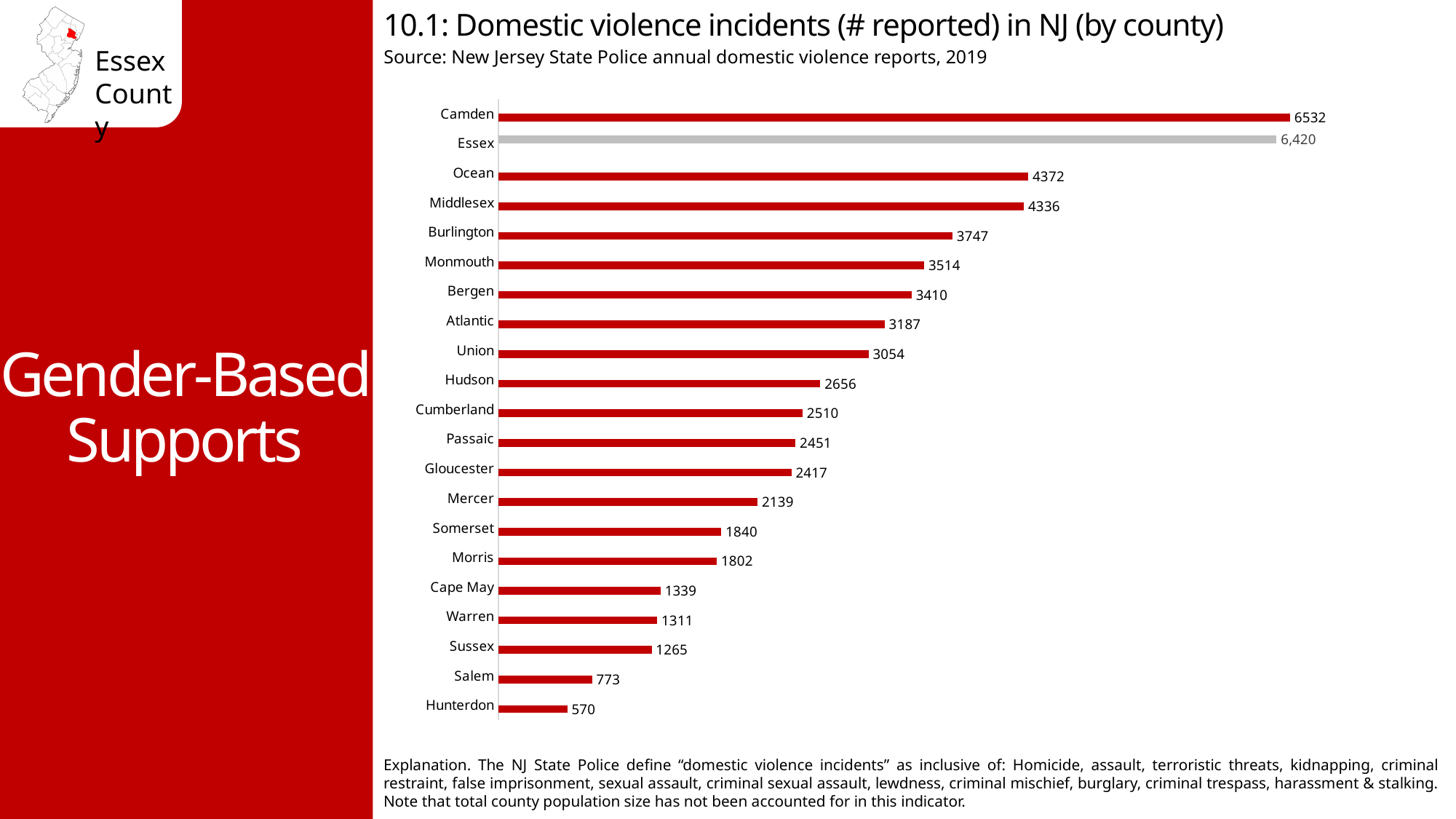
What is the number of domestic violence incidents reported for Cape May County? 1339 Which county has more reported incidents, Hudson or Mercer? Hudson What is the difference between the number of incidents in Salem and Hunterdon? 203 What is the number of domestic violence incidents reported for Bergen County? 3410 Which county has the highest number of reported domestic violence incidents? Camden What is the number of domestic violence incidents reported for Essex County? 6,420 Which county has the lowest number of reported domestic violence incidents? Hunterdon What type of chart is used to show domestic violence incidents by county? Bar chart Which county's bar is shown in grey rather than red? Essex What is the difference between the number of incidents in Camden and Essex? 112 Which county has more reported incidents, Ocean or Middlesex? Ocean How many counties are shown in the chart? 21